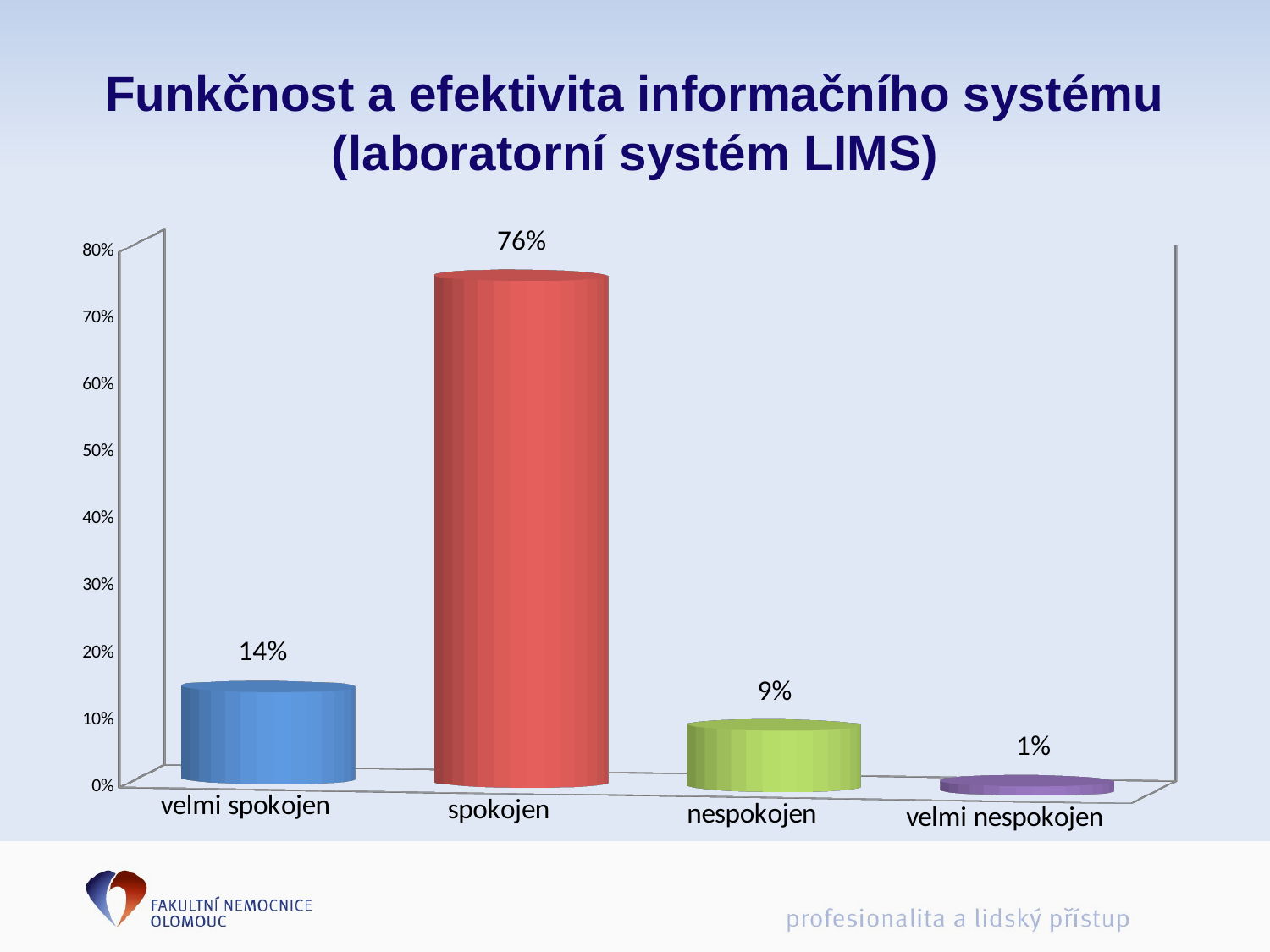
Which is larger, the value for "velmi spokojen" or the value for "nespokojen"? velmi spokojen What kind of chart is shown on the slide? bar chart What is the value for "velmi spokojen"? 14% What is the difference between the values for "velmi spokojen" and "nespokojen"? 5% How many categories are shown on the x axis? 4 What is the value for "spokojen"? 76% Is the value for "spokojen" greater or less than 70%? greater Which category has the lowest value? velmi nespokojen What is the difference between the values for "spokojen" and "velmi spokojen"? 62% What is the value for "velmi nespokojen"? 1% What is the value for "nespokojen"? 9% Which category has the highest value? spokojen